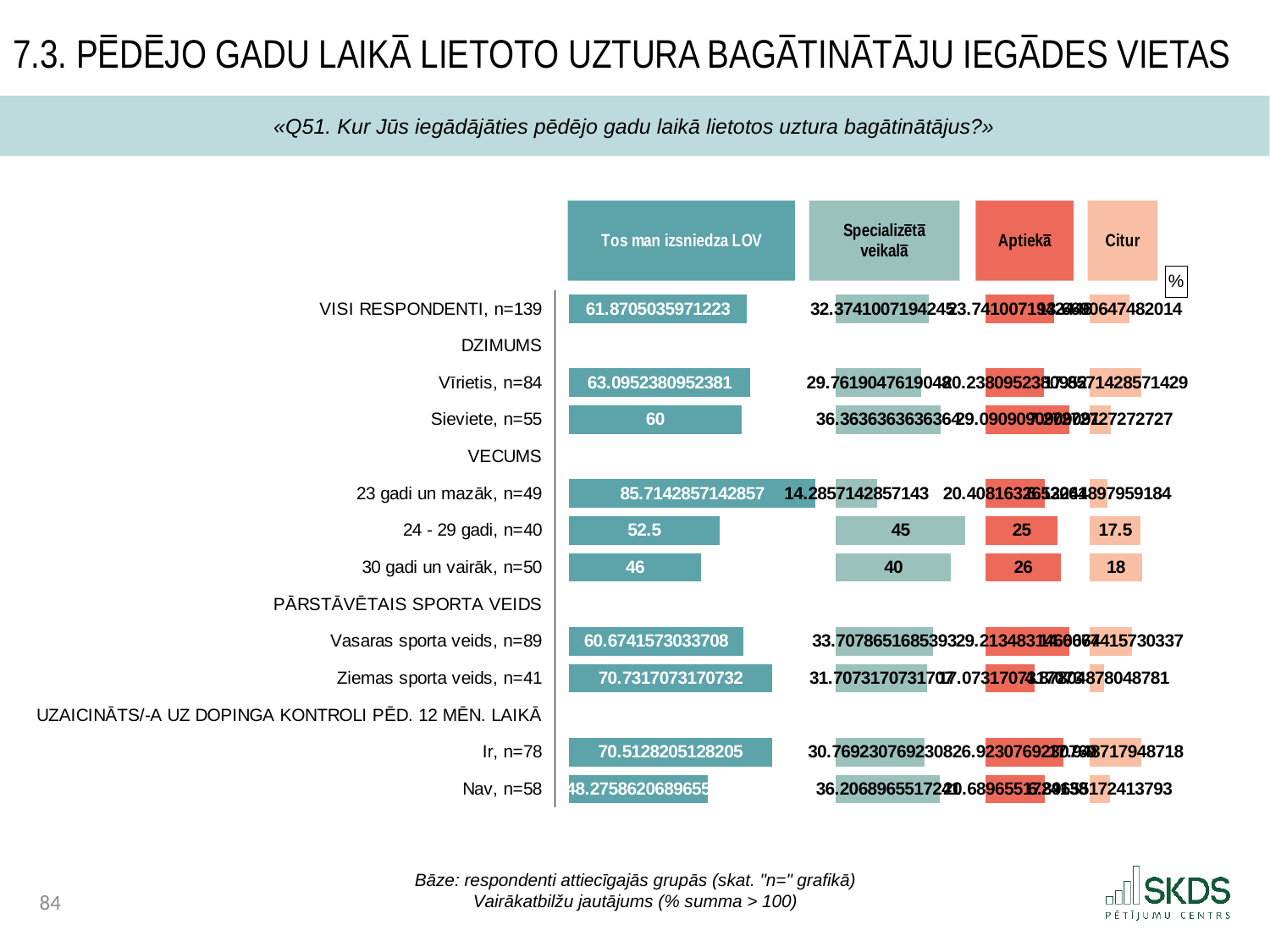
What is the value for "Specializētā veikalā" in the "24 - 29 gadi, n=40" row? 45 What is the value for "Aptiekā" in the "24 - 29 gadi, n=40" row? 25 Which is larger: the "Citur" value for "24 - 29 gadi, n=40" or for "30 gadi un vairāk, n=50"? 30 gadi un vairāk, n=50 What kind of chart is shown on the slide? bar chart In the "30 gadi un vairāk, n=50" row, what is the difference between the "Tos man izsniedza LOV" value and the "Specializētā veikalā" value? 6 Which series is shown in red in the chart? Aptiekā In the "24 - 29 gadi, n=40" row, what is the difference between the "Tos man izsniedza LOV" value and the "Specializētā veikalā" value? 7.5 Which respondent group has the lowest value for "Tos man izsniedza LOV"? Nav, n=58 How many series does the chart legend list? 4 Which respondent group has the highest value for "Tos man izsniedza LOV"? 23 gadi un mazāk, n=49 What is the value for "Tos man izsniedza LOV" in the "Sieviete, n=55" row? 60 What is the value for "Citur" in the "30 gadi un vairāk, n=50" row? 18